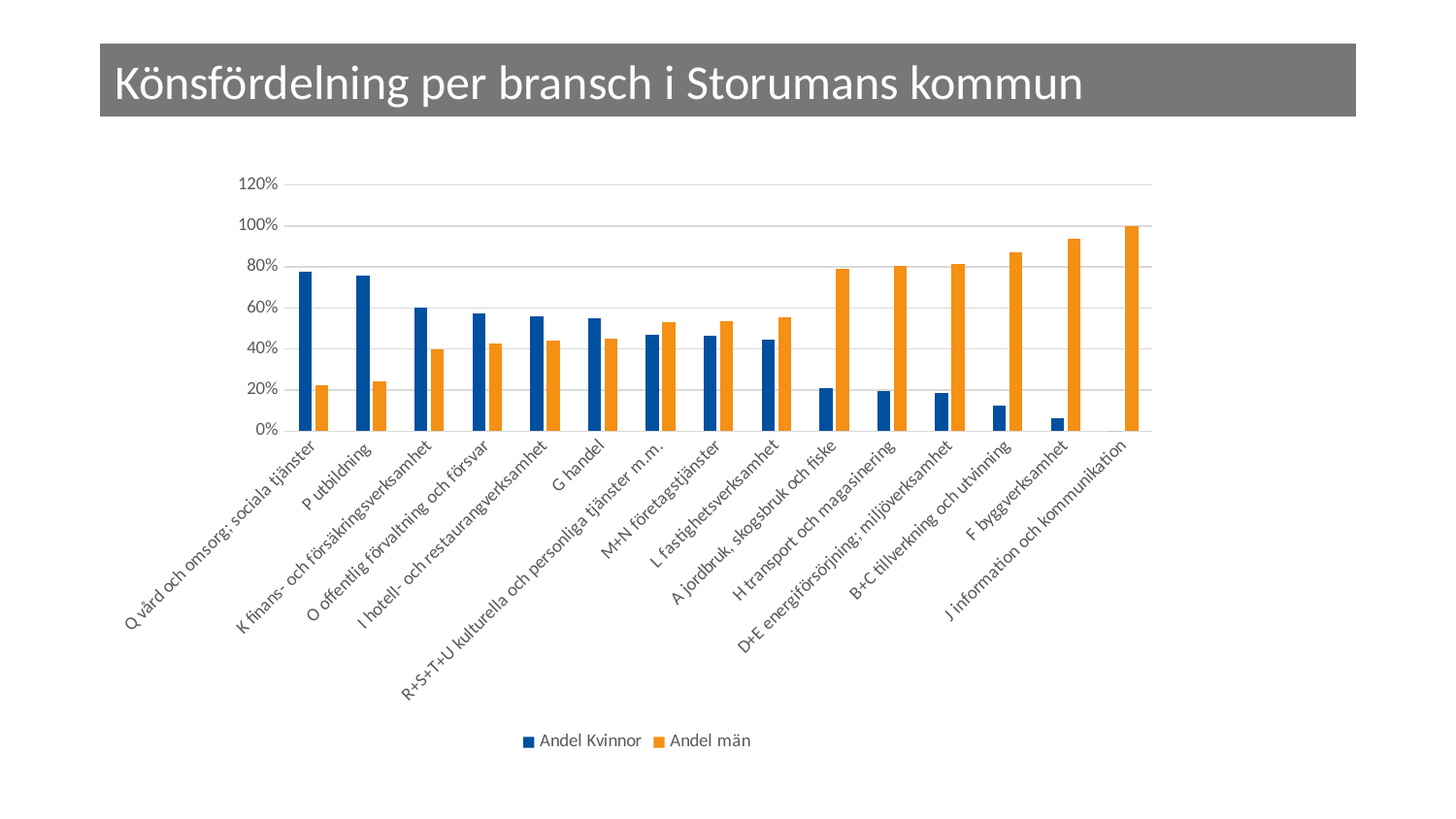
How many series does the legend list? 2 For G handel, which is larger: Andel Kvinnor or Andel män? Andel Kvinnor Is the value of Andel Kvinnor for Q vård och omsorg; sociala tjänster greater or less than 60%? greater Which series is shown in orange? Andel män Which category has the lowest value for Andel Kvinnor? J information och kommunikation Is the value of Andel Kvinnor for B+C tillverkning och utvinning greater or less than 20%? less Is the value of Andel män for F byggverksamhet greater or less than 80%? greater What kind of chart is shown on the slide? Bar chart How many industry categories are shown on the x axis? 15 Do the values for Andel Kvinnor rise or fall from left to right along the x axis? Fall Which category has the highest value for Andel män? J information och kommunikation What is the title of the chart? Könsfördelning per bransch i Storumans kommun